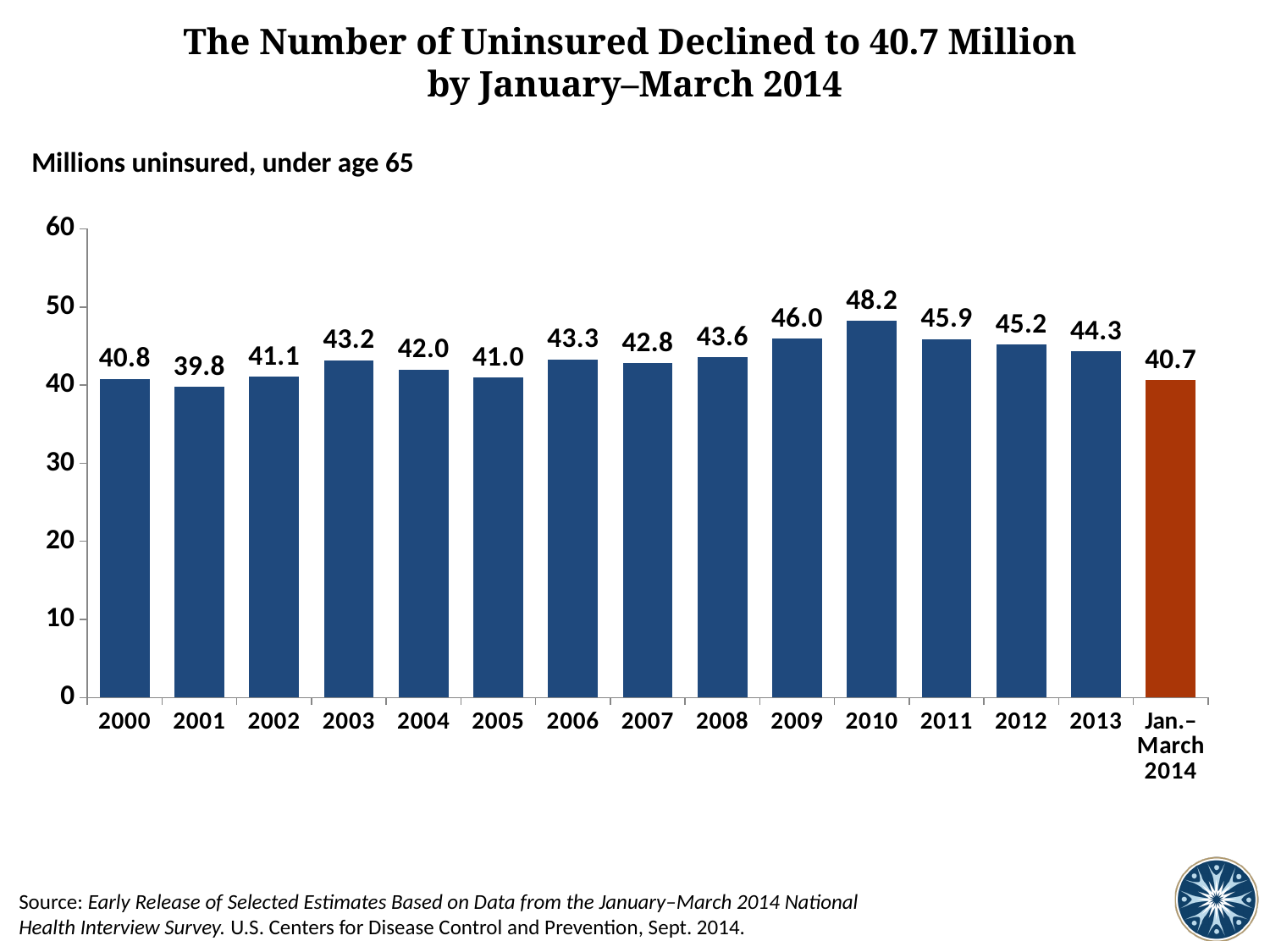
Which year has the highest number of uninsured? 2010 Do the values rise or fall from 2010 to Jan.–March 2014? fall Is the value for 2013 greater or less than 50? less What is the number of uninsured (in millions) shown for 2010? 48.2 What kind of chart is shown on the slide? bar chart Which category has the lowest value on the chart? 2001 What is the value for 2005? 41.0 Which bar is coloured differently from the others? Jan.–March 2014 Which is larger, the value for 2009 or the value for 2012? 2009 How many bars are shown on the chart? 15 What value is shown for Jan.–March 2014? 40.7 What is the difference between the 2010 value and the Jan.–March 2014 value? 7.5